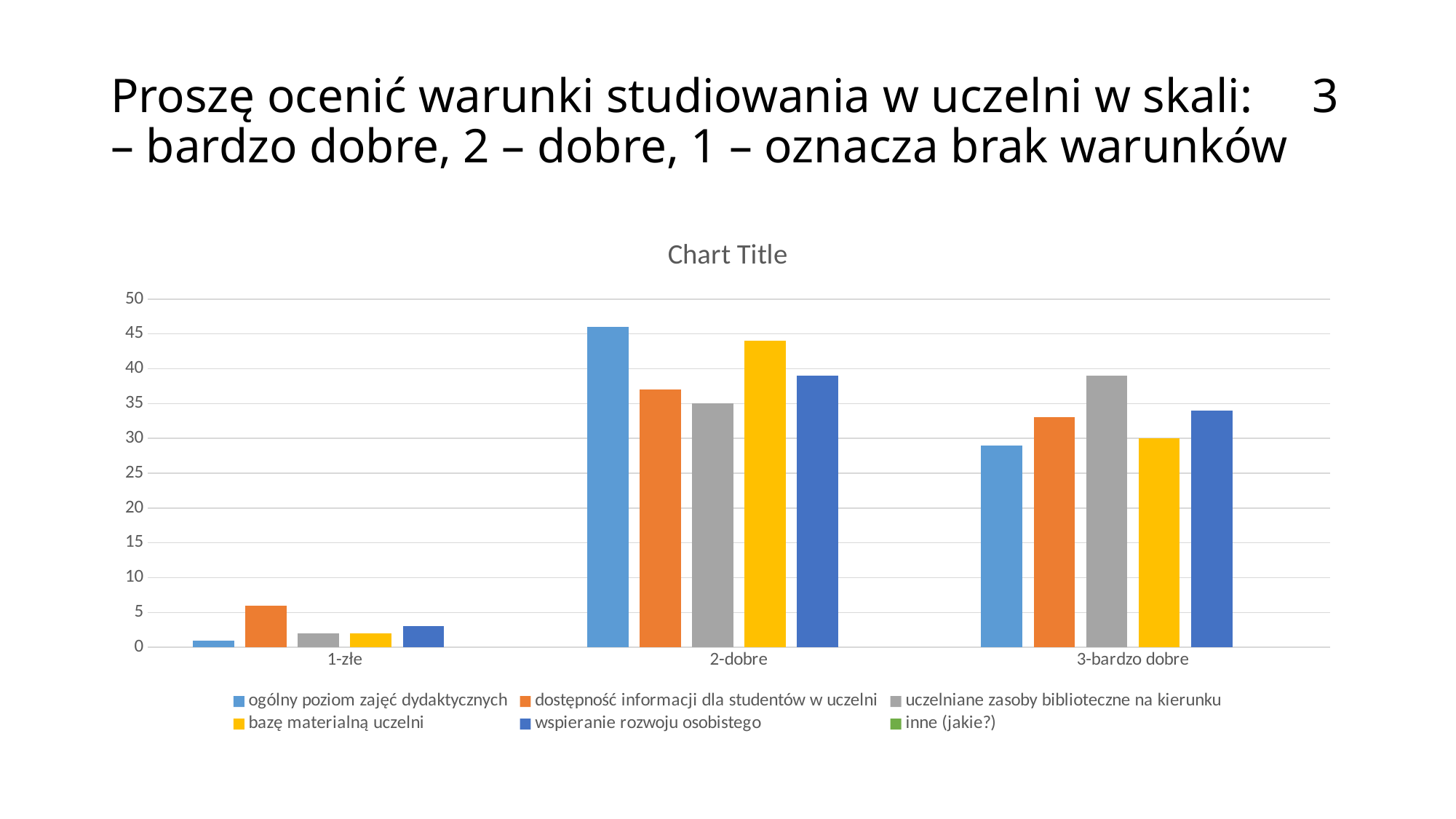
How many series does the chart's legend list? 6 Is the value for 'uczelniane zasoby biblioteczne na kierunku' in the '3-bardzo dobre' category greater or less than 35? greater Which series is shown in yellow in the chart's legend? bazę materialną uczelni What is the title shown above the chart? Chart Title How many categories are shown on the x axis of the chart? 3 For 'ogólny poziom zajęć dydaktycznych', which category has the larger value: '2-dobre' or '3-bardzo dobre'? 2-dobre Is the value for 'ogólny poziom zajęć dydaktycznych' in the '3-bardzo dobre' category greater or less than 35? less Which series has the highest bar in the '1-złe' category? dostępność informacji dla studentów w uczelni Is the value for 'ogólny poziom zajęć dydaktycznych' in the '2-dobre' category greater or less than 40? greater What kind of chart is shown on the slide? bar chart Which series has the highest bar in the '3-bardzo dobre' category? uczelniane zasoby biblioteczne na kierunku